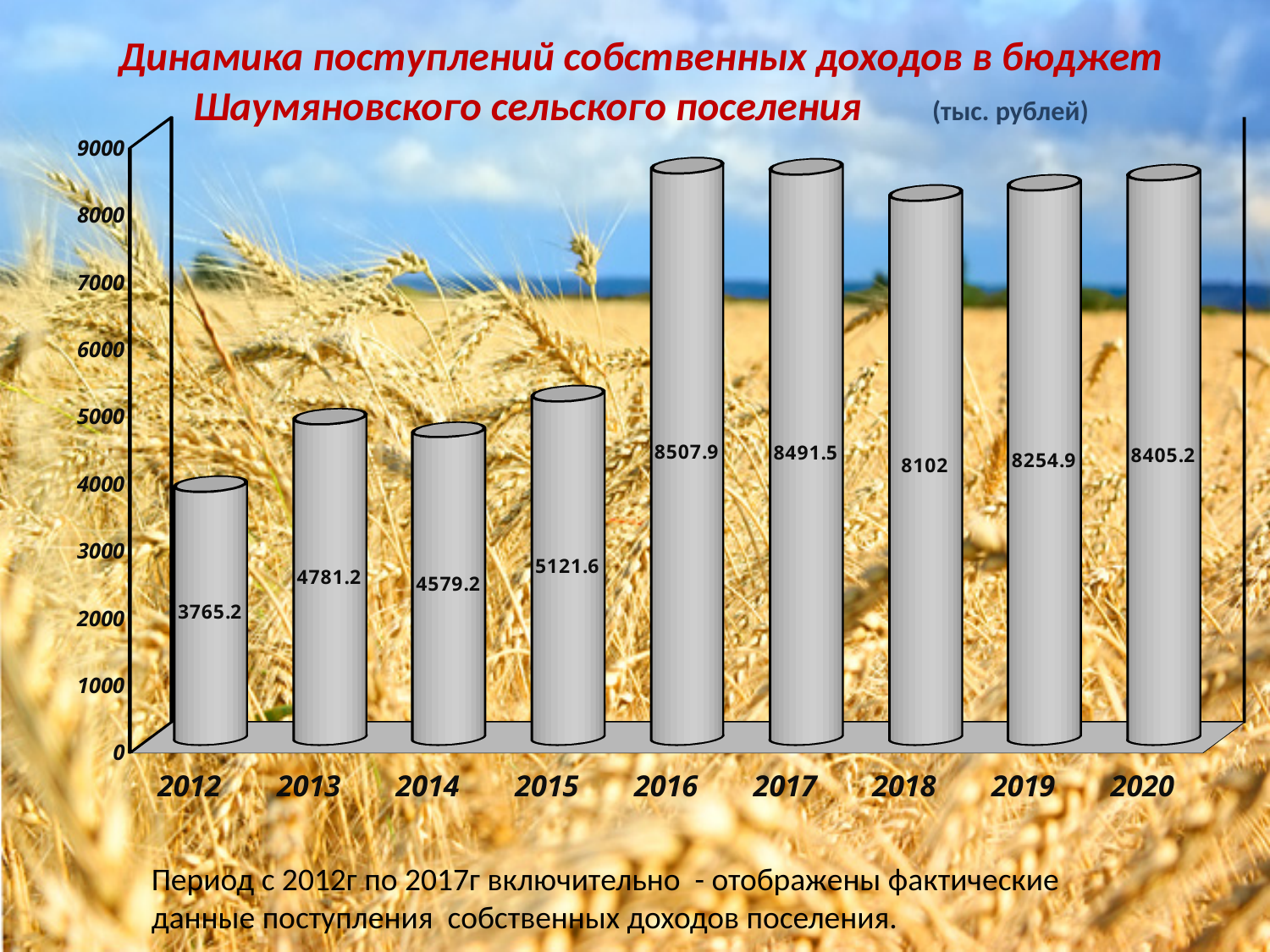
How many years are shown on the x axis? 9 Is the value for 2015 greater or less than 5000? greater What is the difference between the values for 2016 and 2012? 4742.7 Which is larger, the value for 2018 or the value for 2019? 2019 What is the difference between the values for 2013 and 2014? 202 Which year has the highest value? 2016 What kind of chart is shown on the slide? bar chart What is the value for 2018? 8102 Which year has the lowest value? 2012 What is the value for 2020? 8405.2 What is the value for 2012? 3765.2 Does the value rise or fall from 2013 to 2014? fall